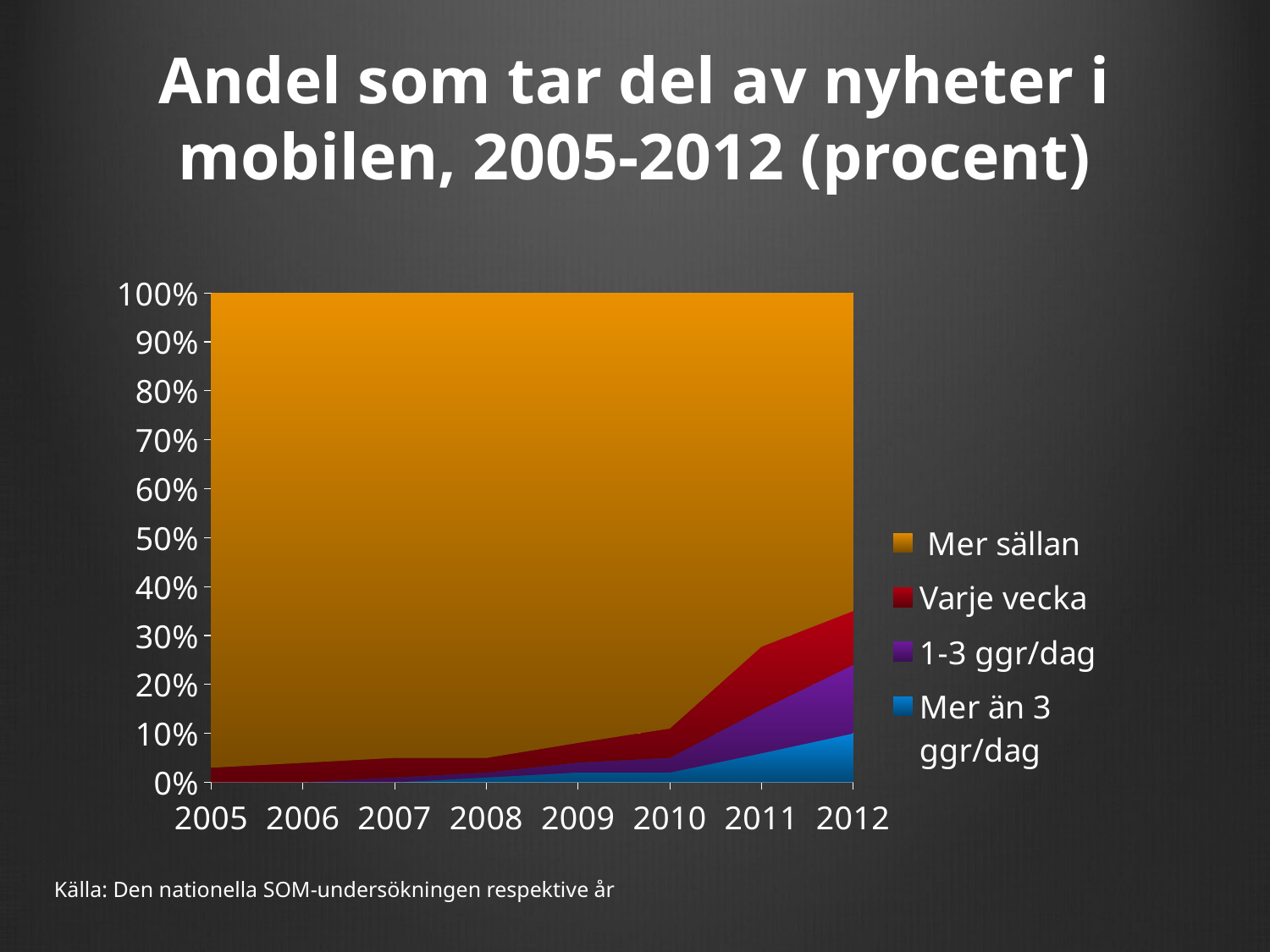
What kind of chart is shown on the slide? Stacked area chart Which year has the largest share for 'Mer än 3 ggr/dag'? 2012 Is the share for 'Mer sällan' in 2012 greater or less than 60%? greater How many series does the chart's legend list? 4 In which year is the share for 'Mer sällan' smallest? 2012 Does the share for 'Mer sällan' rise or fall from 2005 to 2012? Fall Which colour represents 'Mer sällan' in the chart? Orange Is the share for 'Mer sällan' in 2005 greater or less than 90%? greater Does the share for 'Mer än 3 ggr/dag' rise or fall from 2005 to 2012? Rise What is the title of the chart? Andel som tar del av nyheter i mobilen, 2005-2012 (procent) Which is larger: the share for 'Mer sällan' in 2005 or in 2012? 2005 How many years are plotted along the x axis of the chart? 8